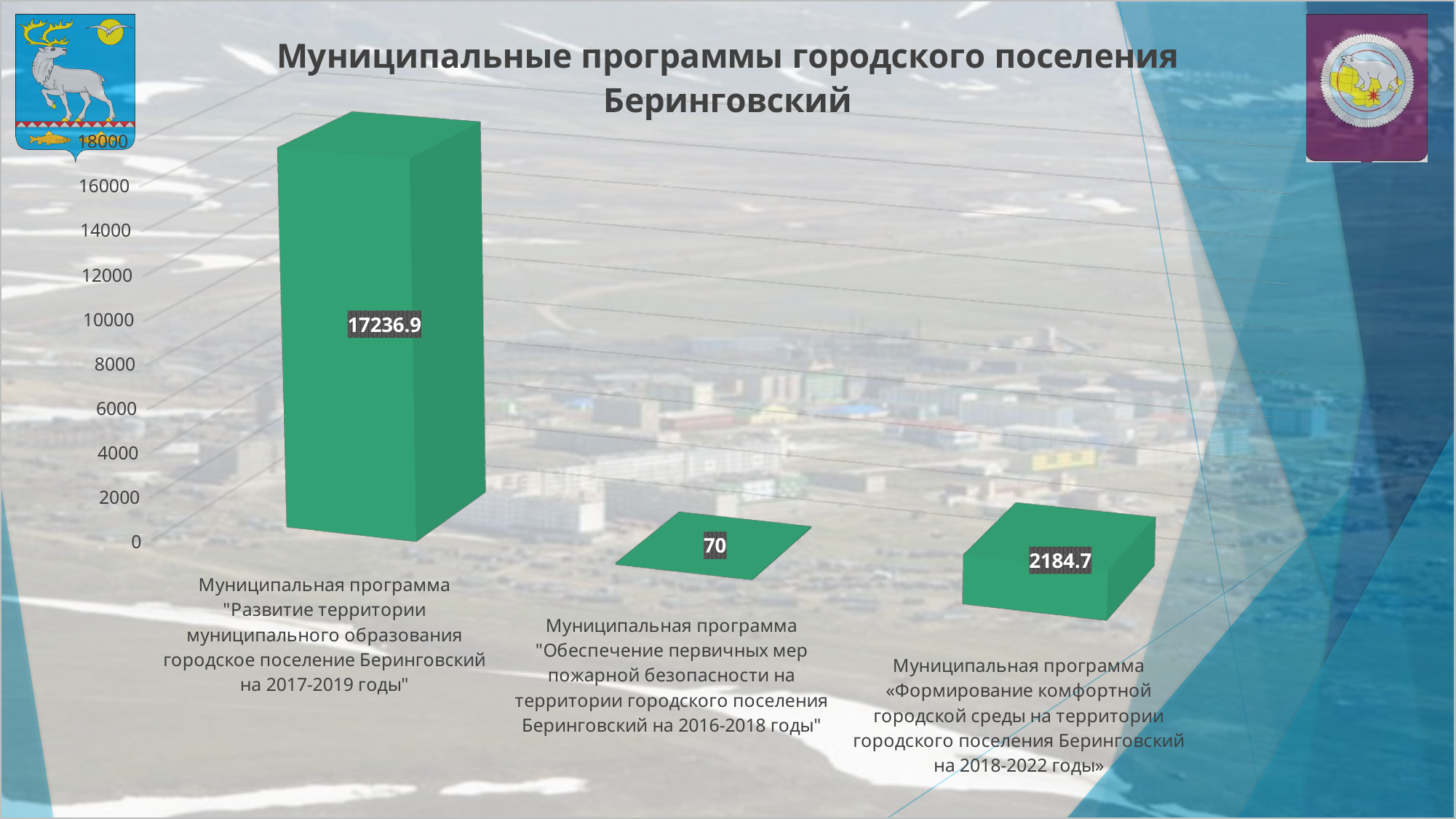
How many municipal programs are shown on the chart? 3 What is the title of the slide's chart? Муниципальные программы городского поселения Беринговский Which municipal program has the lowest value on the chart? Обеспечение первичных мер пожарной безопасности на территории городского поселения Беринговский на 2016-2018 годы What is the value shown for the municipal program "Развитие территории муниципального образования городское поселение Беринговский на 2017-2019 годы"? 17236.9 Is the value for the "Развитие территории" program greater or less than 16000? greater What is the value shown for the municipal program «Формирование комфортной городской среды на территории городского поселения Беринговский на 2018-2022 годы»? 2184.7 What is the value shown for the municipal program "Обеспечение первичных мер пожарной безопасности на территории городского поселения Беринговский на 2016-2018 годы"? 70 What is the difference between the value for the «Формирование комфортной городской среды» program and the value for the "Обеспечение первичных мер пожарной безопасности" program? 2114.7 Which has a larger value: the «Формирование комфортной городской среды» program or the "Обеспечение первичных мер пожарной безопасности" program? Формирование комфортной городской среды Which municipal program has the highest value on the chart? Развитие территории муниципального образования городское поселение Беринговский на 2017-2019 годы What is the difference between the value for the "Развитие территории" program and the value for the «Формирование комфортной городской среды» program? 15052.2 What kind of chart is shown on the slide? bar chart